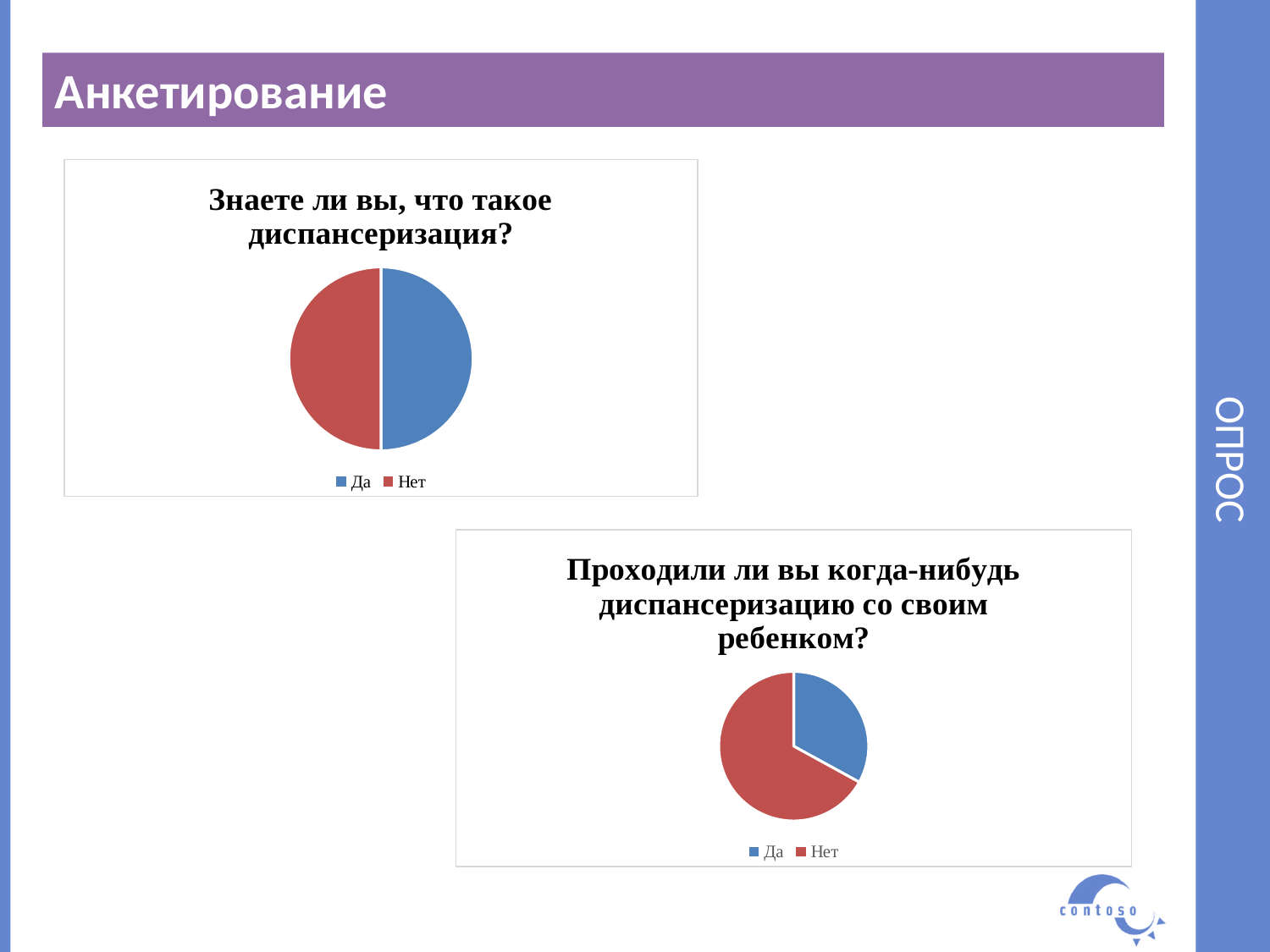
What kind of chart is the chart titled "Проходили ли вы когда-нибудь диспансеризацию со своим ребенком?"? pie chart How many slices does the pie chart titled "Знаете ли вы, что такое диспансеризация?" have? 2 What entries does the legend of the chart titled "Знаете ли вы, что такое диспансеризация?" list? Да, Нет In the chart titled "Проходили ли вы когда-нибудь диспансеризацию со своим ребенком?", which slice is the smallest? Да In the chart titled "Проходили ли вы когда-нибудь диспансеризацию со своим ребенком?", what colour is the Нет slice? red How many slices does the pie chart titled "Проходили ли вы когда-нибудь диспансеризацию со своим ребенком?" have? 2 How many charts are shown on the slide? 2 In the chart titled "Проходили ли вы когда-нибудь диспансеризацию со своим ребенком?", which slice is the largest? Нет In the chart titled "Проходили ли вы когда-нибудь диспансеризацию со своим ребенком?", which is larger, Да or Нет? Нет What kind of chart is the chart titled "Знаете ли вы, что такое диспансеризация?"? pie chart